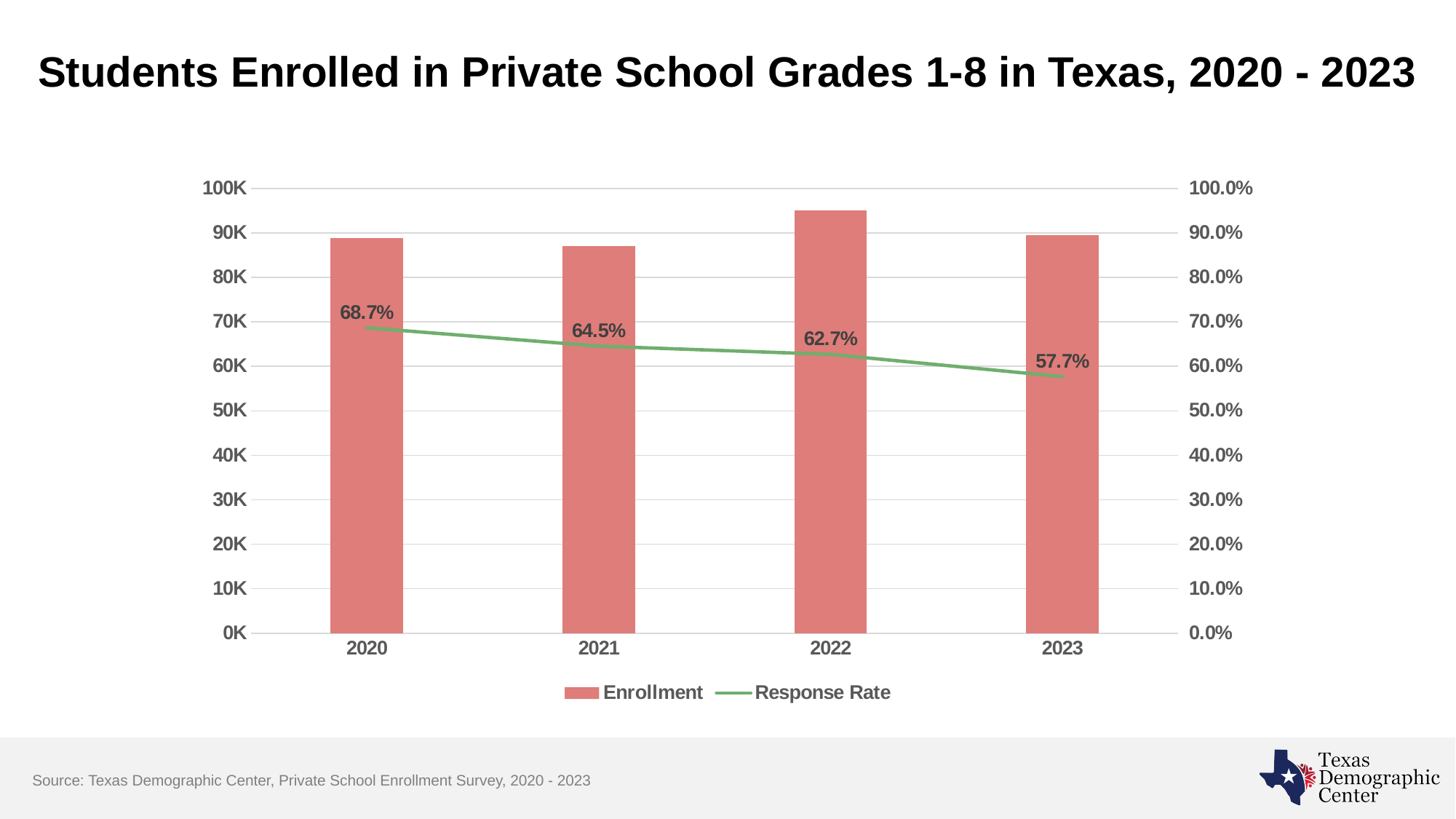
Does the response rate rise or fall from 2020 to 2023? fall Is the enrollment value for 2021 greater or less than 90K? less What was the response rate in 2023? 57.7% Which year had the highest response rate? 2020 What was the response rate in 2020? 68.7% How many series does the legend list? 2 Is the enrollment value for 2022 greater or less than 90K? greater By how many percentage points did the response rate fall from 2020 to 2023? 11.0 percentage points Which year had higher enrollment, 2021 or 2022? 2022 What was the response rate in 2021? 64.5% Which year had the highest enrollment? 2022 Which year had the lowest response rate? 2023